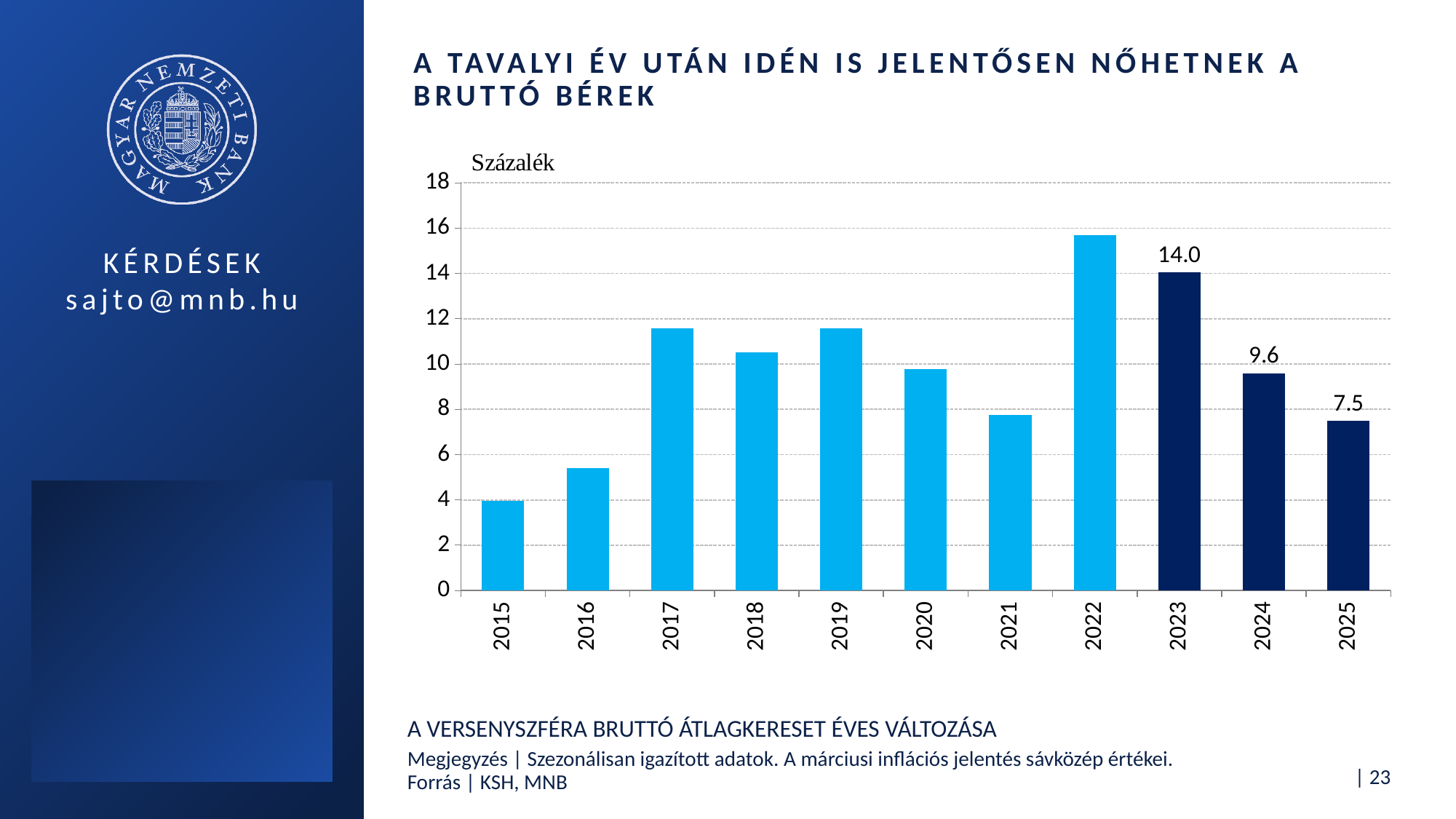
What kind of chart is shown on the slide? bar chart What is the difference between the values for 2024 and 2025? 2.1 What is the value shown for 2025? 7.5 Which year has the larger value, 2017 or 2018? 2017 Which year has the highest bar? 2022 Is the value for 2022 greater or less than 14? greater Is the value for 2015 greater or less than 6? less What is the difference between the values for 2023 and 2024? 4.4 How many years are shown on the x axis? 11 Which year has the lowest bar? 2015 Do the values rise or fall from 2023 to 2025? fall What is the value shown for 2023? 14.0